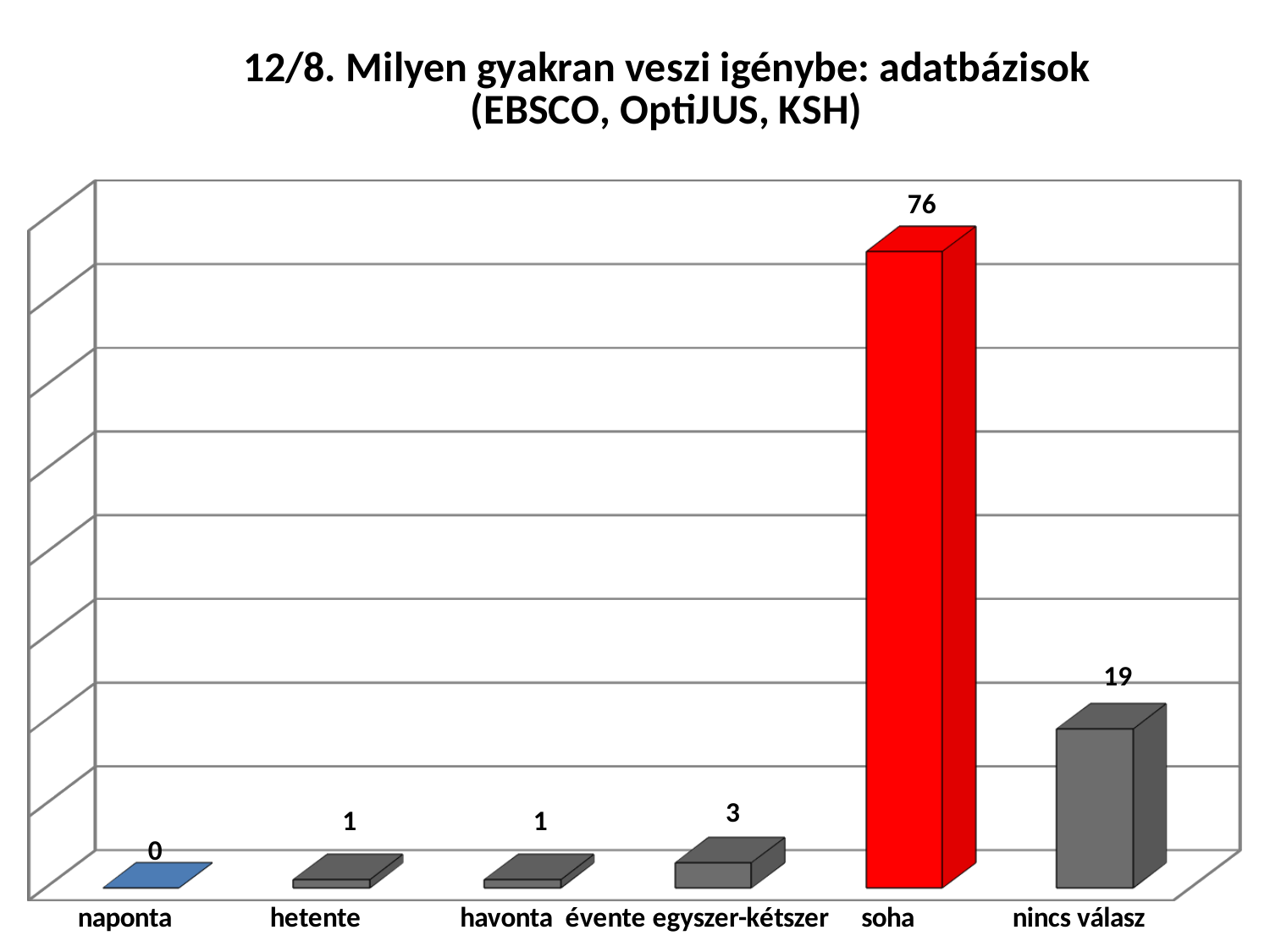
What is the value for "évente egyszer-kétszer"? 3 Which is larger, the value for "nincs válasz" or the value for "évente egyszer-kétszer"? nincs válasz How many categories are shown on the x axis? 6 What is the value for "hetente"? 1 What is the value for "soha"? 76 What kind of chart is shown on the slide? bar chart What is the value for "naponta"? 0 What colour is the bar for "soha"? red What is the difference between the values for "soha" and "nincs válasz"? 57 Which category has the highest value? soha What is the value for "nincs válasz"? 19 Which category has the lowest value? naponta